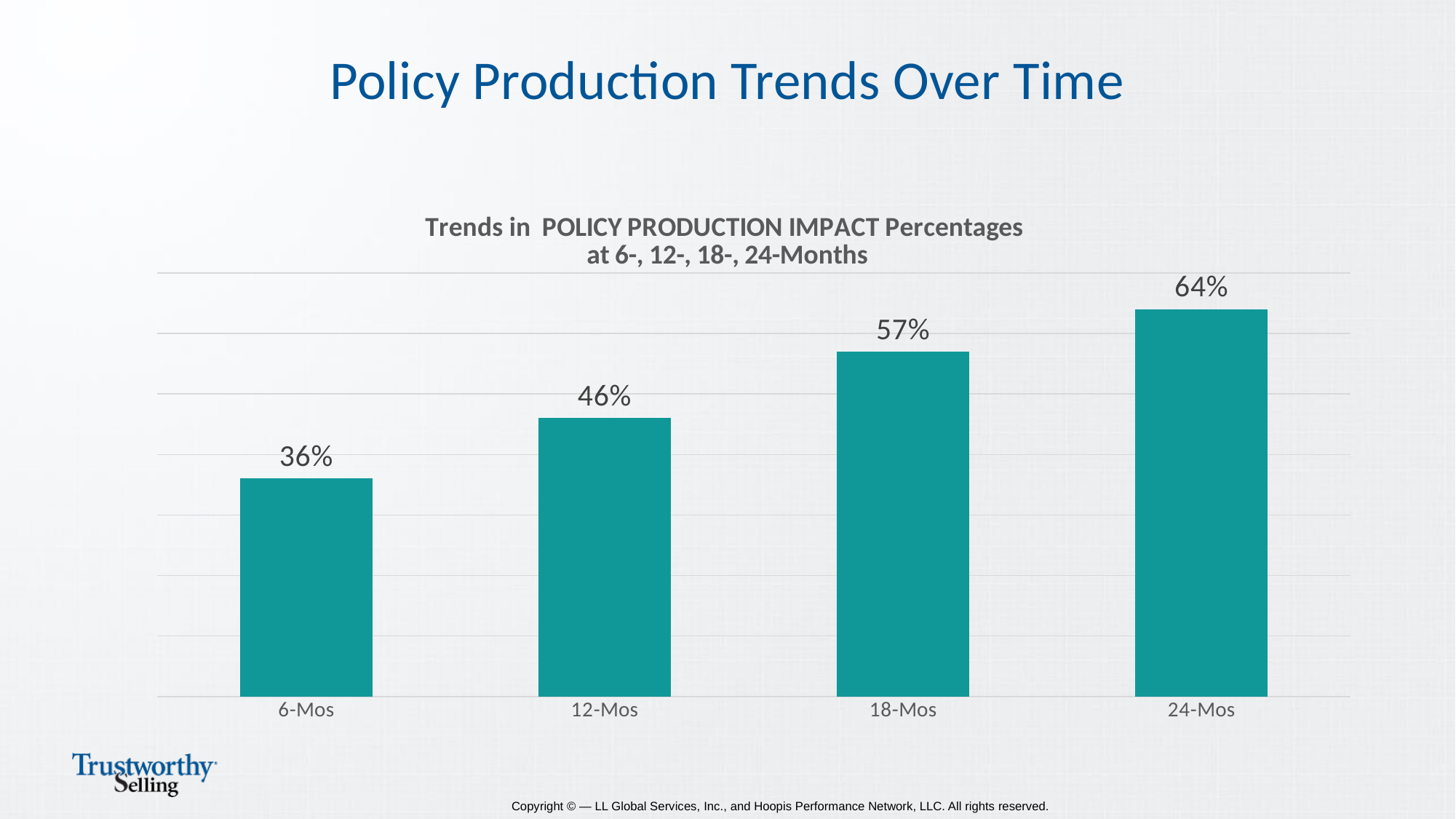
How many categories are shown on the x axis? 4 What is the value for 12-Mos? 46% Which is larger, the value for 12-Mos or the value for 18-Mos? 18-Mos Which category has the lowest value? 6-Mos What kind of chart is shown on the slide? Bar chart Do the values rise or fall from 6-Mos to 24-Mos? Rise What is the value for 6-Mos? 36% What is the difference between the values for 24-Mos and 6-Mos? 28% Which category has the highest value? 24-Mos What is the difference between the values for 18-Mos and 12-Mos? 11% What is the value for 24-Mos? 64% What is the value for 18-Mos? 57%